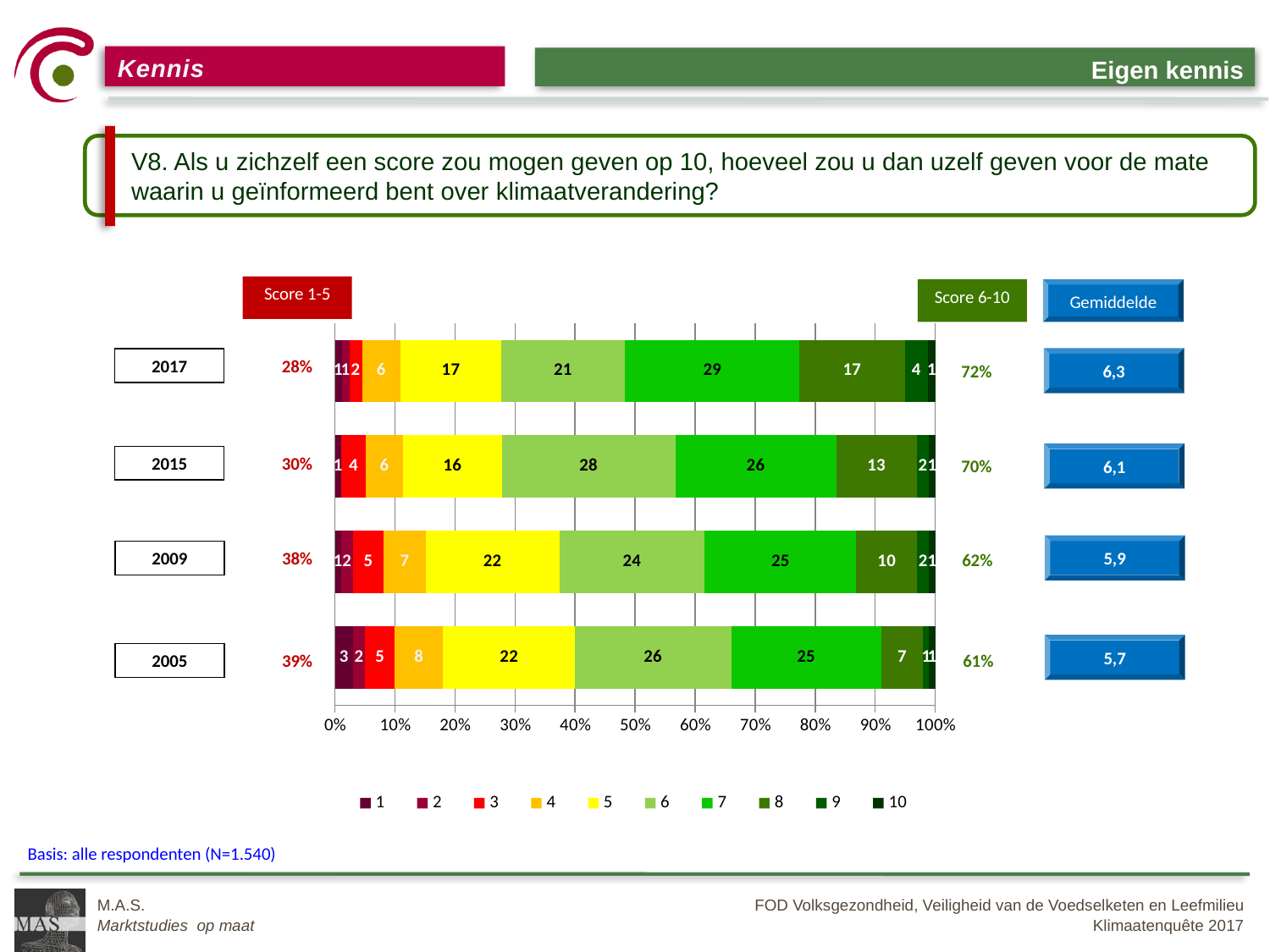
What share of respondents gave a Score 1-5 in 2005? 39% How many series does the legend list? 10 Which year has the lowest Score 6-10 percentage? 2005 What is the value for score 6 in 2015? 28 How many years are shown in the chart? 4 Which year has the larger value for score 8: 2017 or 2015? 2017 What share of respondents gave a Score 6-10 in 2009? 62% Which year has the highest Gemiddelde (average) score? 2017 What percentage of respondents gave themselves a score of 7 in 2017? 29 What is the Gemiddelde (average) shown for 2017? 6,3 What is the difference between the score 7 value in 2017 and in 2005? 4 What kind of chart is shown on the slide? Stacked bar chart